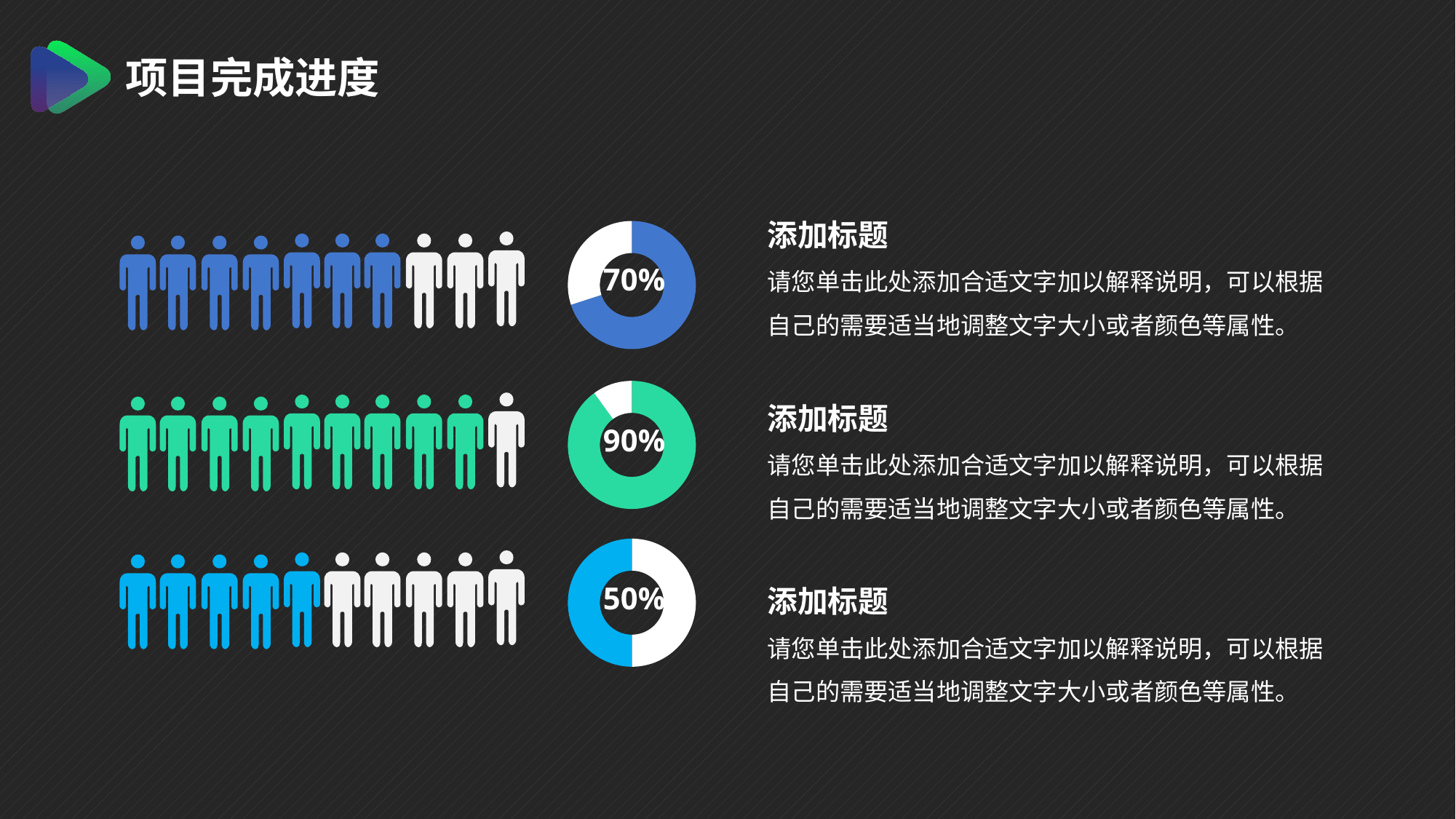
What is the difference between the percentage in the top donut chart and the percentage in the bottom donut chart? 20% What is the difference between the percentage in the middle donut chart and the percentage in the bottom donut chart? 40% In the bottom row of person icons, how many icons are coloured (not white)? 5 In the top row of person icons, how many icons are coloured blue? 7 What value is shown in the bottom donut chart? 50% What value is shown in the top donut chart? 70% What colour is the filled portion of the middle donut chart? green Which of the three donut charts shows the highest percentage: top, middle or bottom? middle What value is shown in the middle donut chart? 90% Is the percentage in the top donut chart larger or smaller than the percentage in the middle donut chart? smaller Which of the three donut charts shows the lowest percentage: top, middle or bottom? bottom How many donut charts are on the slide? 3